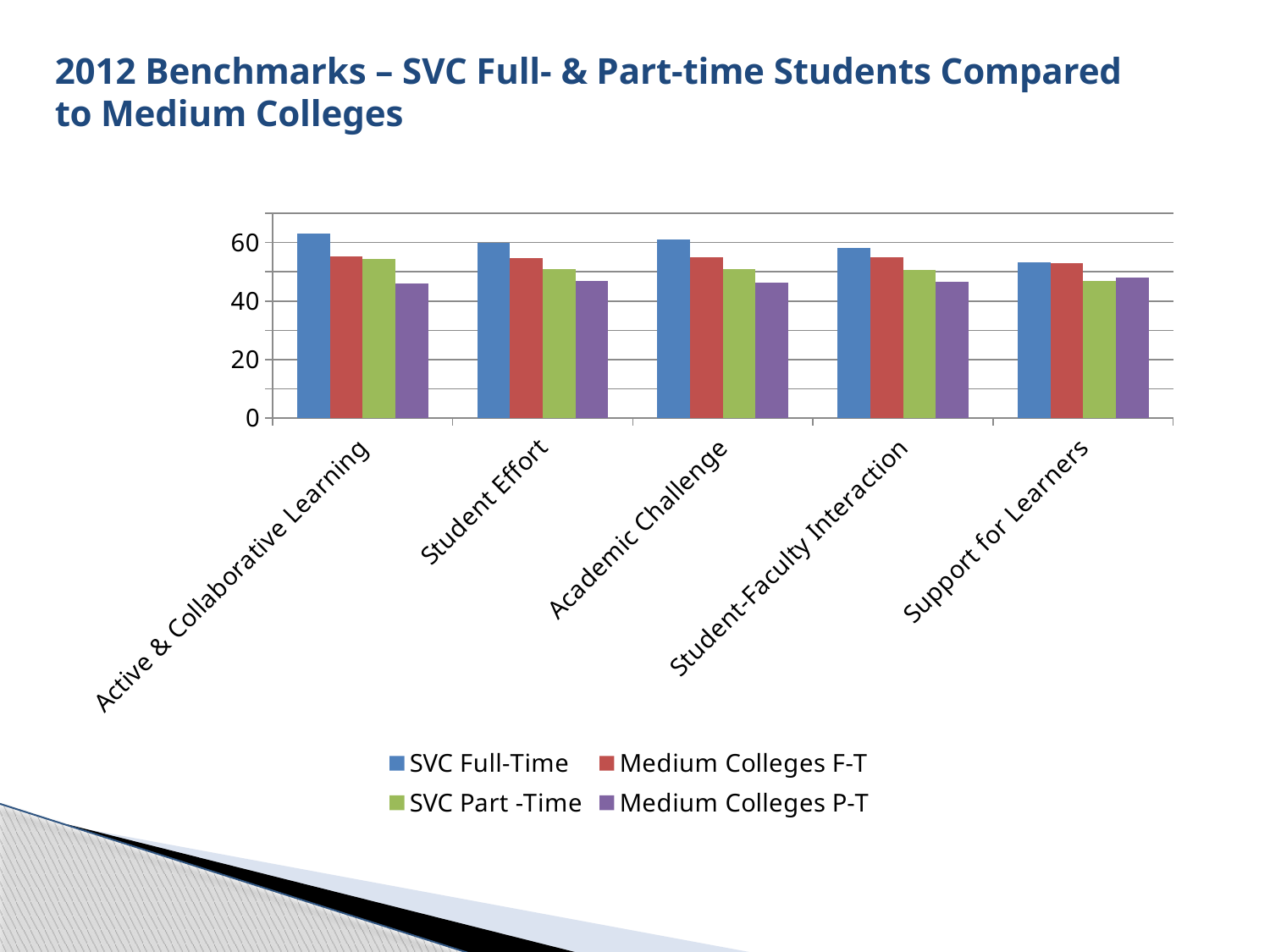
Within Active & Collaborative Learning, which series has the highest bar? SVC Full-Time What kind of chart is shown on the slide? bar chart Is the SVC Full-Time value for Active & Collaborative Learning greater or less than 60? greater Within Active & Collaborative Learning, which series has the lowest bar? Medium Colleges P-T Is the Medium Colleges P-T value for Active & Collaborative Learning greater or less than 60? less For Academic Challenge, which is larger: SVC Full-Time or Medium Colleges P-T? SVC Full-Time Is the SVC Full-Time value for Support for Learners greater or less than 60? less What colour represents SVC Part -Time in the legend? green How many series does the legend list? 4 How many benchmark categories are shown on the x axis? 5 For which category is the SVC Full-Time bar the lowest? Support for Learners